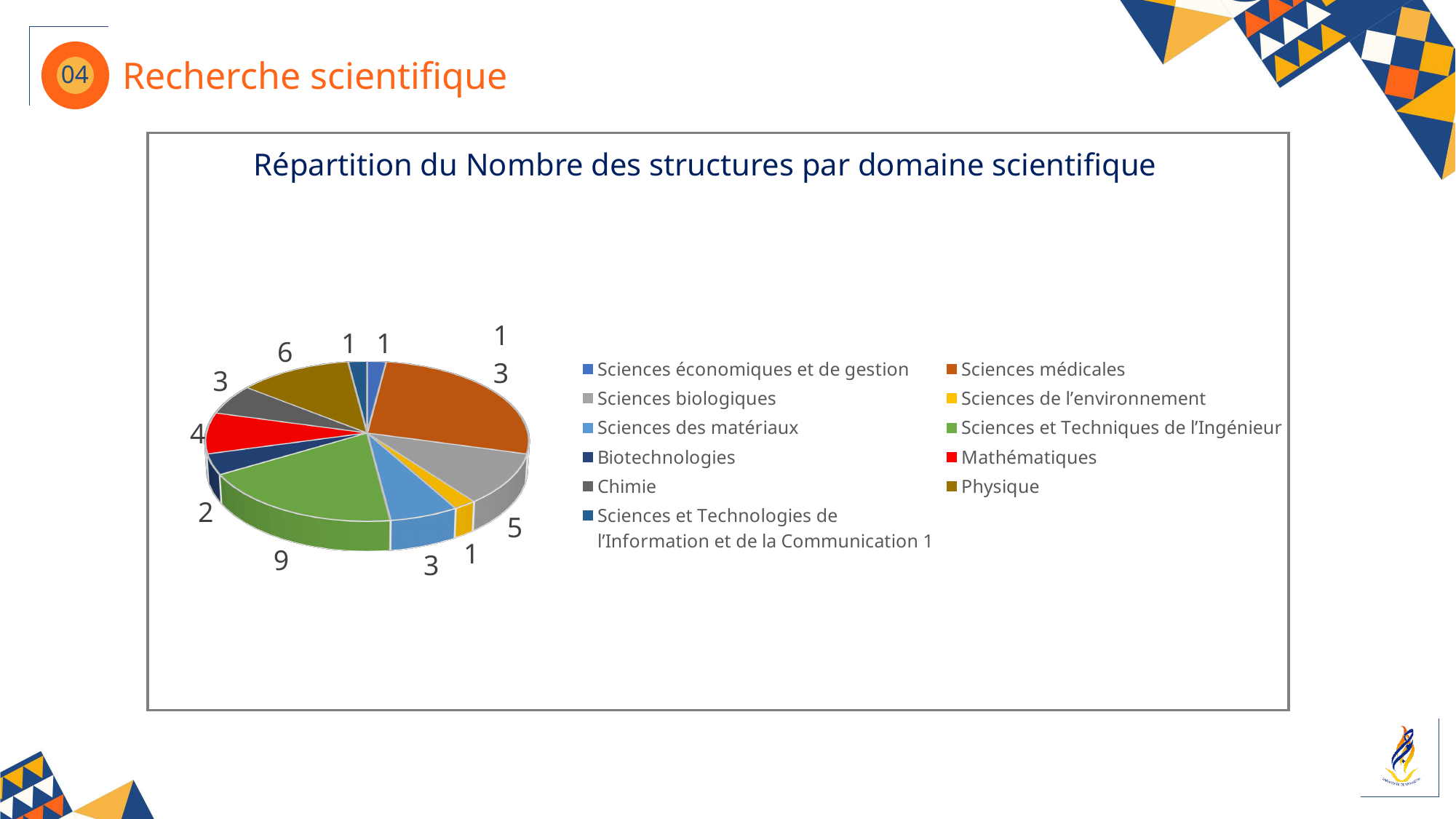
How many categories does the legend of the pie chart list? 11 What is the difference between the value for Sciences et Techniques de l'Ingénieur and the value for Physique? 3 Which is larger, the value for Physique or the value for Mathématiques? Physique What is the title of the chart? Répartition du Nombre des structures par domaine scientifique What is the value for Sciences et Techniques de l'Ingénieur? 9 What kind of chart is shown on the slide? pie chart What is the value for Biotechnologies? 2 What is the value for Sciences de l'environnement? 1 What is the value for Physique? 6 What is the value for Sciences biologiques? 5 What is the value for Mathématiques? 4 Which domain has the largest slice of the pie? Sciences médicales